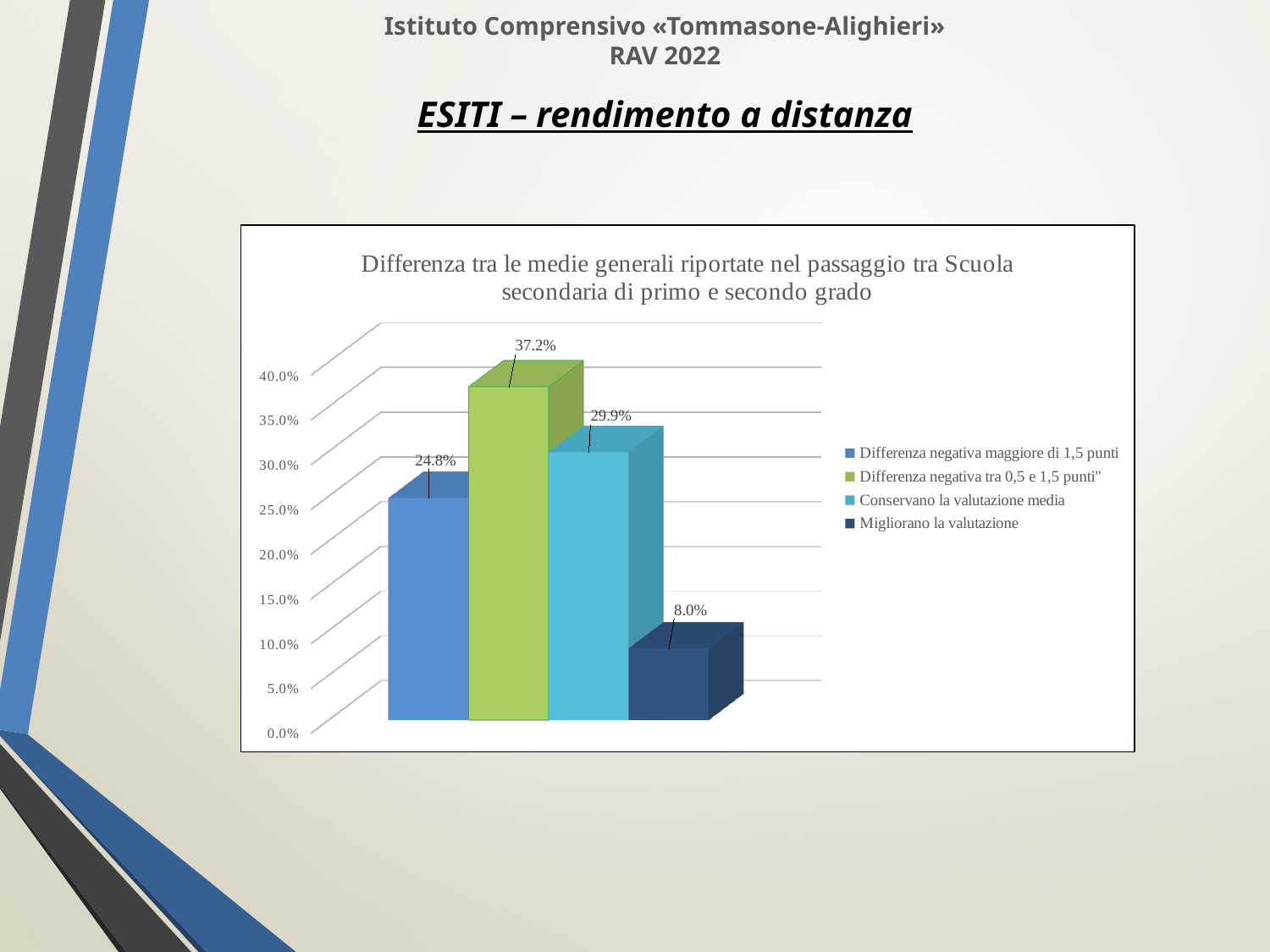
What is the difference between the values for "Differenza negativa tra 0,5 e 1,5 punti" and "Conservano la valutazione media"? 7.3% What is the value for "Conservano la valutazione media"? 29.9% What is the value for "Differenza negativa maggiore di 1,5 punti"? 24.8% Is the value for "Migliorano la valutazione" greater or less than 10.0%? less Which category has the highest value? Differenza negativa tra 0,5 e 1,5 punti What colour is the bar for "Differenza negativa tra 0,5 e 1,5 punti"? green What is the value for "Differenza negativa tra 0,5 e 1,5 punti"? 37.2% What kind of chart is shown on the slide? bar chart How many bars are plotted in the chart? 4 Which is larger: the value for "Conservano la valutazione media" or the value for "Differenza negativa maggiore di 1,5 punti"? Conservano la valutazione media Which category has the lowest value? Migliorano la valutazione What is the value for "Migliorano la valutazione"? 8.0%